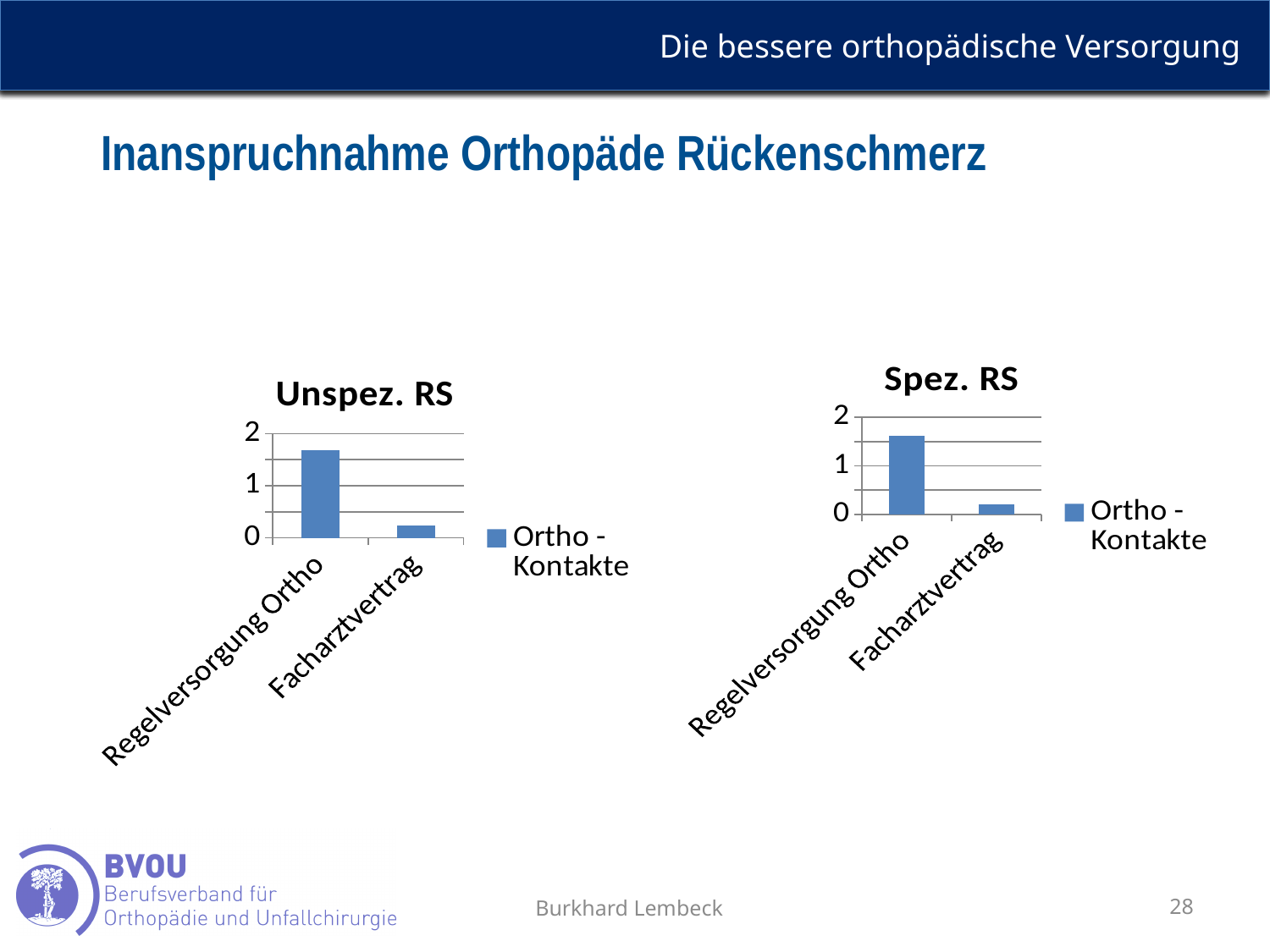
In the "Spez. RS" chart, which category has the lowest value? Facharztvertrag In the "Unspez. RS" chart, which category has the lowest value? Facharztvertrag In the "Spez. RS" chart, which category has the highest value? Regelversorgung Ortho In the "Unspez. RS" chart, is the value for Facharztvertrag greater or less than 1? less In the "Spez. RS" chart, is the value for Regelversorgung Ortho greater or less than 1? greater What series does the legend of the "Unspez. RS" chart list? Ortho - Kontakte How many categories are shown in the "Unspez. RS" chart? 2 In the "Unspez. RS" chart, is the value for Regelversorgung Ortho greater or less than 1? greater What type of chart is the "Spez. RS" chart? Bar chart In the "Unspez. RS" chart, which category has the highest value? Regelversorgung Ortho In the "Spez. RS" chart, which is larger: Regelversorgung Ortho or Facharztvertrag? Regelversorgung Ortho